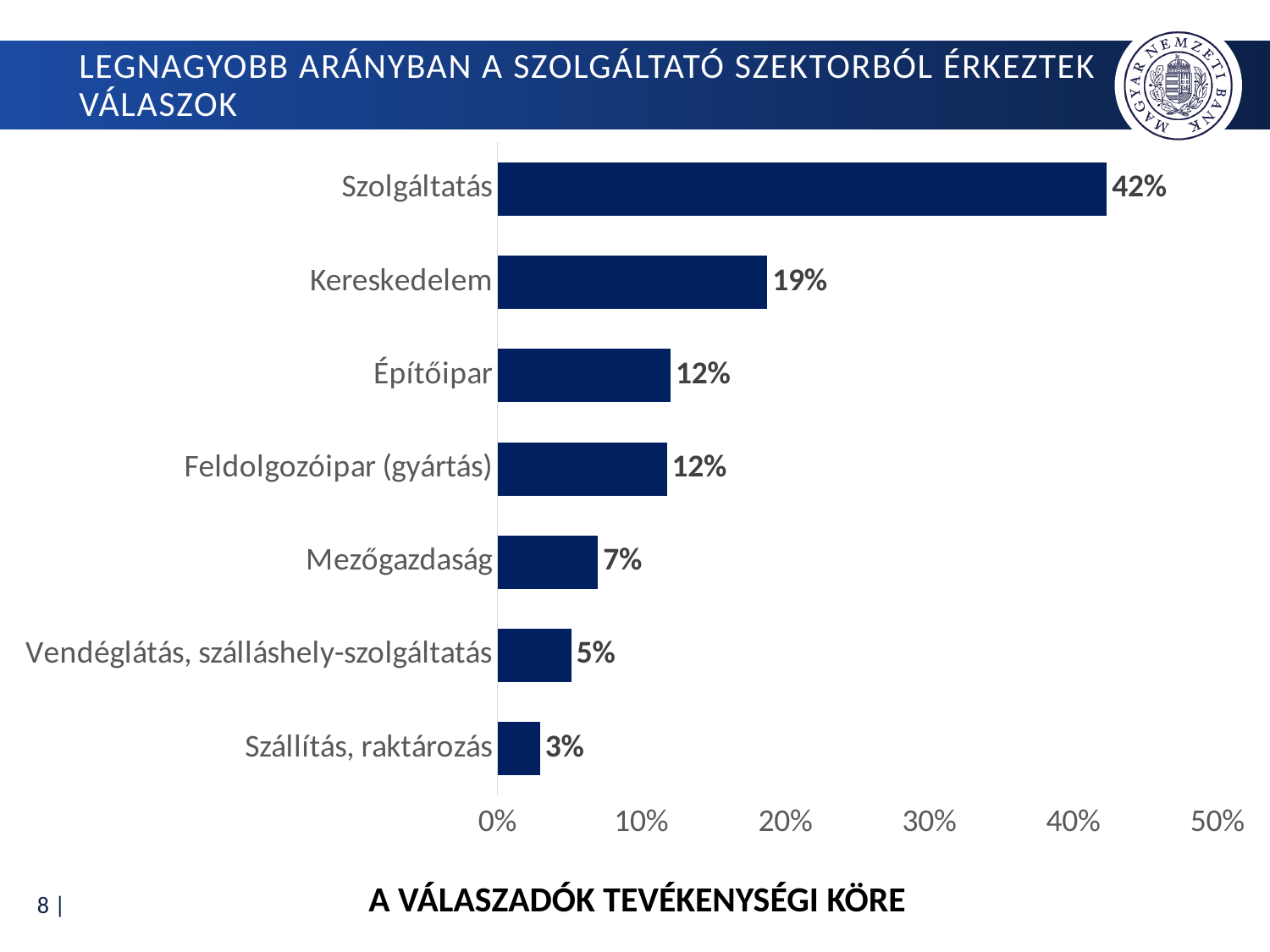
What is the title shown below the chart? A VÁLASZADÓK TEVÉKENYSÉGI KÖRE What is the value for Mezőgazdaság? 7% Which category has the lowest value? Szállítás, raktározás Is the value for Kereskedelem greater or less than 20%? less What is the value for Szolgáltatás? 42% What kind of chart is shown on the slide? bar chart What is the difference between the values for Szolgáltatás and Kereskedelem? 23% Which category has the highest value? Szolgáltatás How many categories are shown in the chart? 7 What is the value for Kereskedelem? 19% What is the value for Szállítás, raktározás? 3% Which is larger, the value for Mezőgazdaság or the value for Vendéglátás, szálláshely-szolgáltatás? Mezőgazdaság